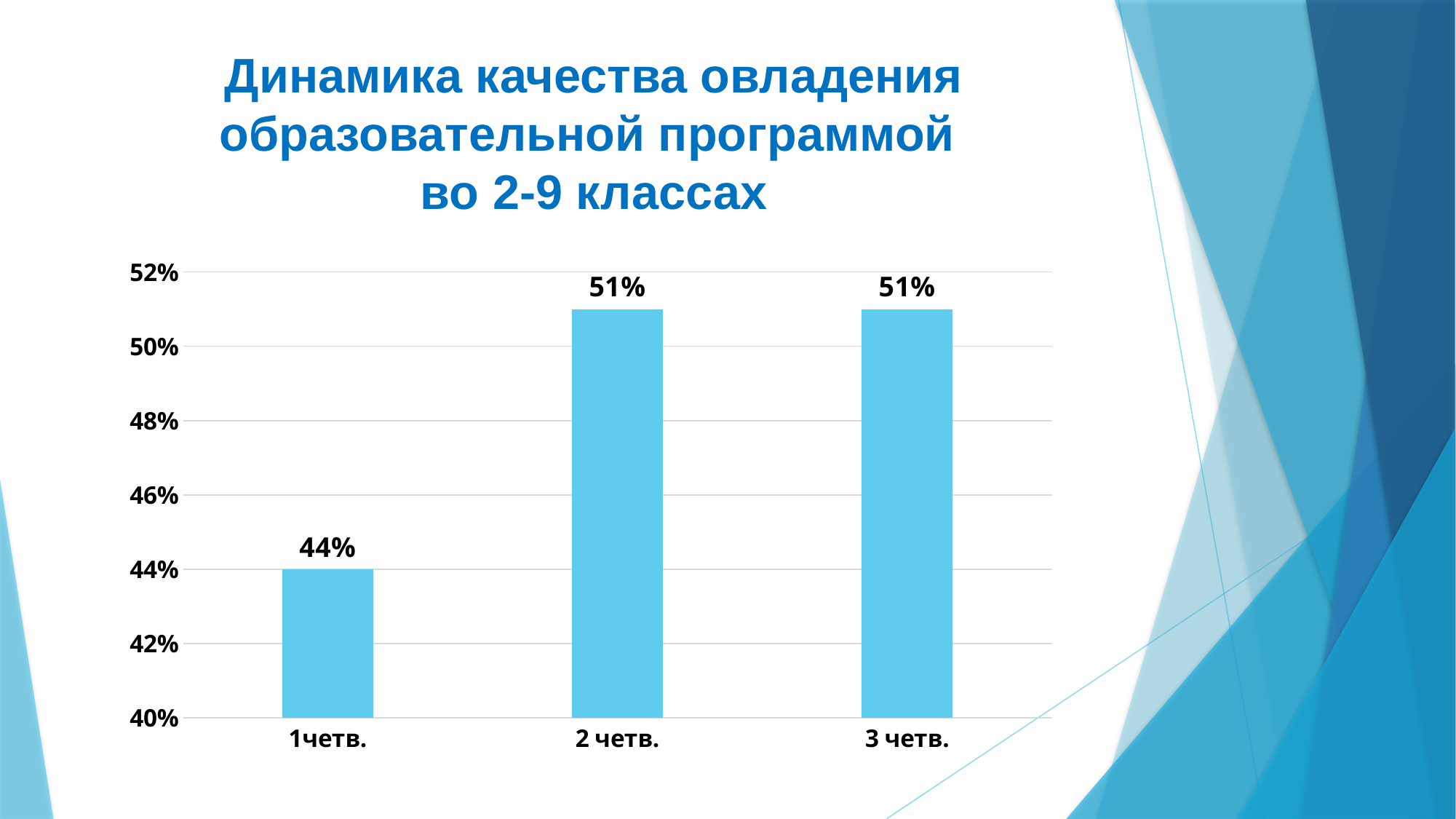
Is the value for 2 четв. greater or less than 50%? greater What kind of chart is shown on the slide? bar chart What is the difference between the values for 2 четв. and 1четв.? 7% Is the value for 1четв. greater or less than 46%? less Which is larger, the value for 1четв. or the value for 3 четв.? 3 четв. Which category has the lowest value? 1четв. How many categories are shown on the x axis? 3 What is the value for 2 четв.? 51% Do the values rise or fall from 1четв. to 2 четв.? rise What is the title of the slide? Динамика качества овладения образовательной программой во 2-9 классах What is the value for 1четв.? 44% What is the value for 3 четв.? 51%